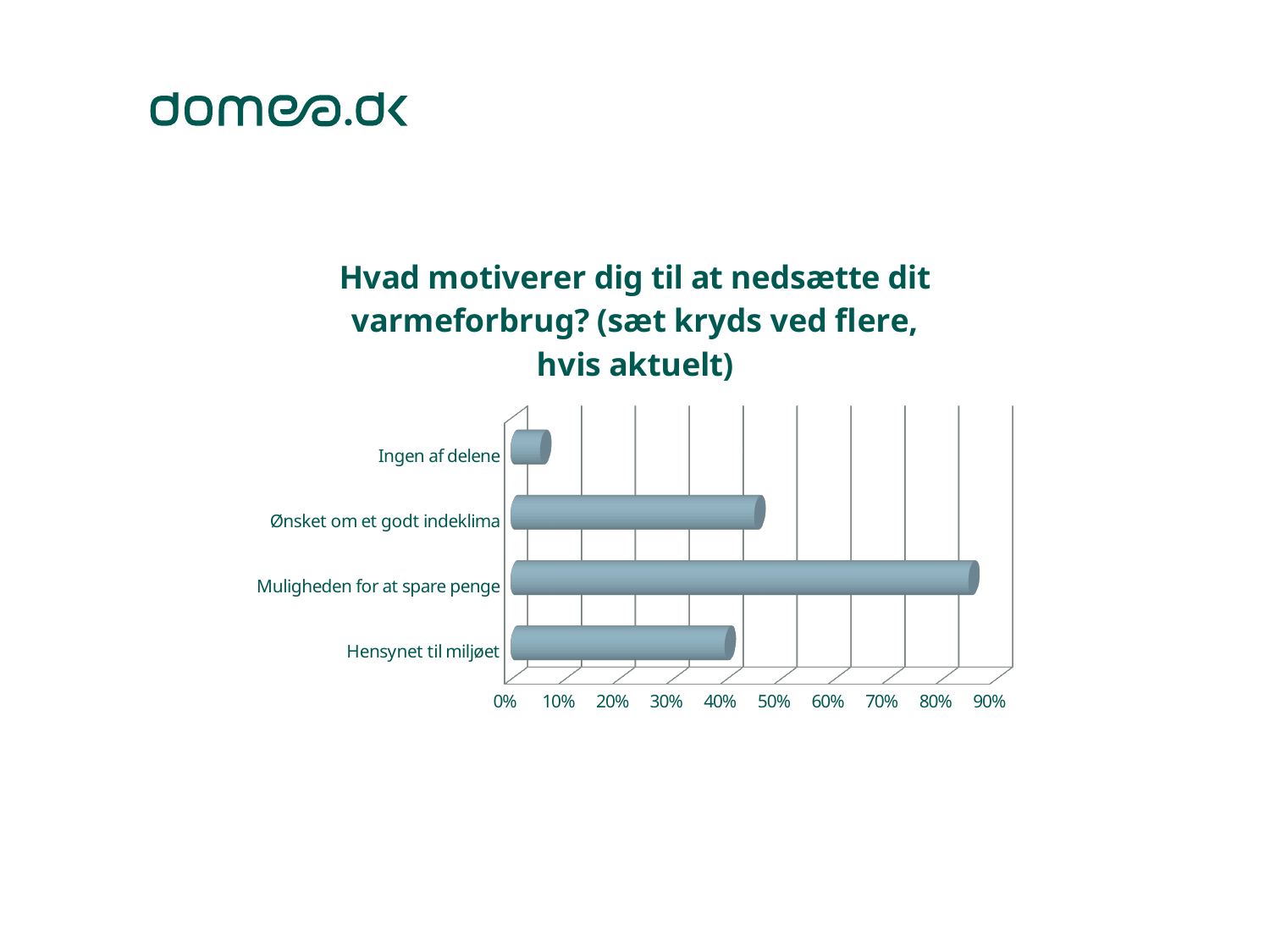
How many categories are shown in the chart? 4 Which is larger, the value for Ønsket om et godt indeklima or the value for Ingen af delene? Ønsket om et godt indeklima Is the value for Ingen af delene greater or less than 10%? less What kind of chart is shown on the slide? bar chart Is the value for Muligheden for at spare penge greater or less than 80%? greater Which category has the lowest value? Ingen af delene Is the value for Ønsket om et godt indeklima greater or less than 40%? greater What is the title of the chart? Hvad motiverer dig til at nedsætte dit varmeforbrug? (sæt kryds ved flere, hvis aktuelt) Which category has the highest value? Muligheden for at spare penge Which is larger, the value for Muligheden for at spare penge or the value for Hensynet til miljøet? Muligheden for at spare penge